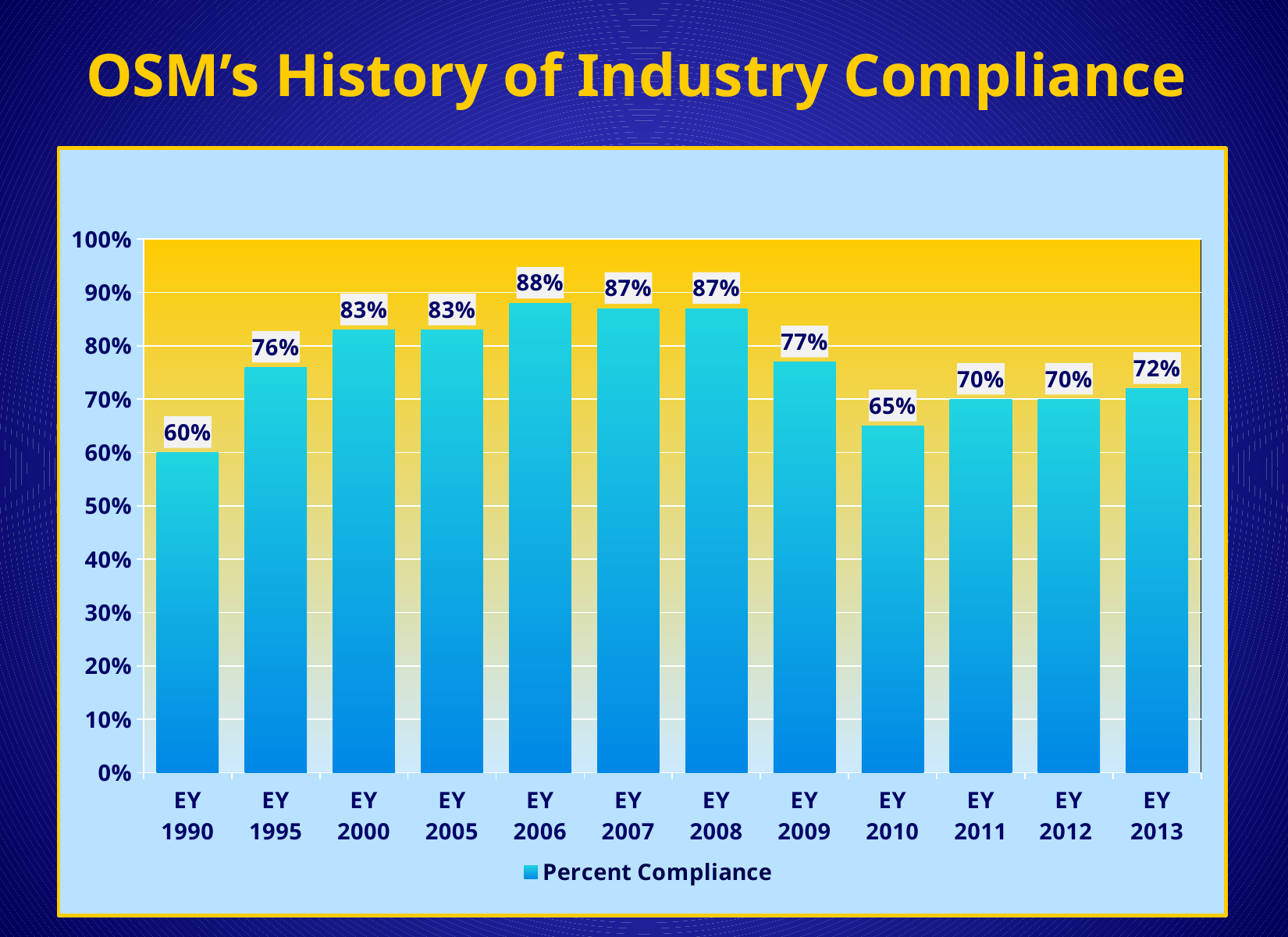
Which has a higher percent compliance, EY 2000 or EY 2011? EY 2000 What is the percent compliance for EY 2009? 77% What is the percent compliance for EY 1990? 60% What kind of chart is shown on the slide? Bar chart What is the difference in percent compliance between EY 1995 and EY 1990? 16% What is the percent compliance for EY 2013? 72% What is the difference in percent compliance between EY 2006 and EY 2010? 23% What is the title of the slide? OSM's History of Industry Compliance How many years are shown on the x axis? 12 Which year has the highest percent compliance? EY 2006 Which year has the lowest percent compliance? EY 1990 Is the percent compliance for EY 2010 greater or less than 70%? less